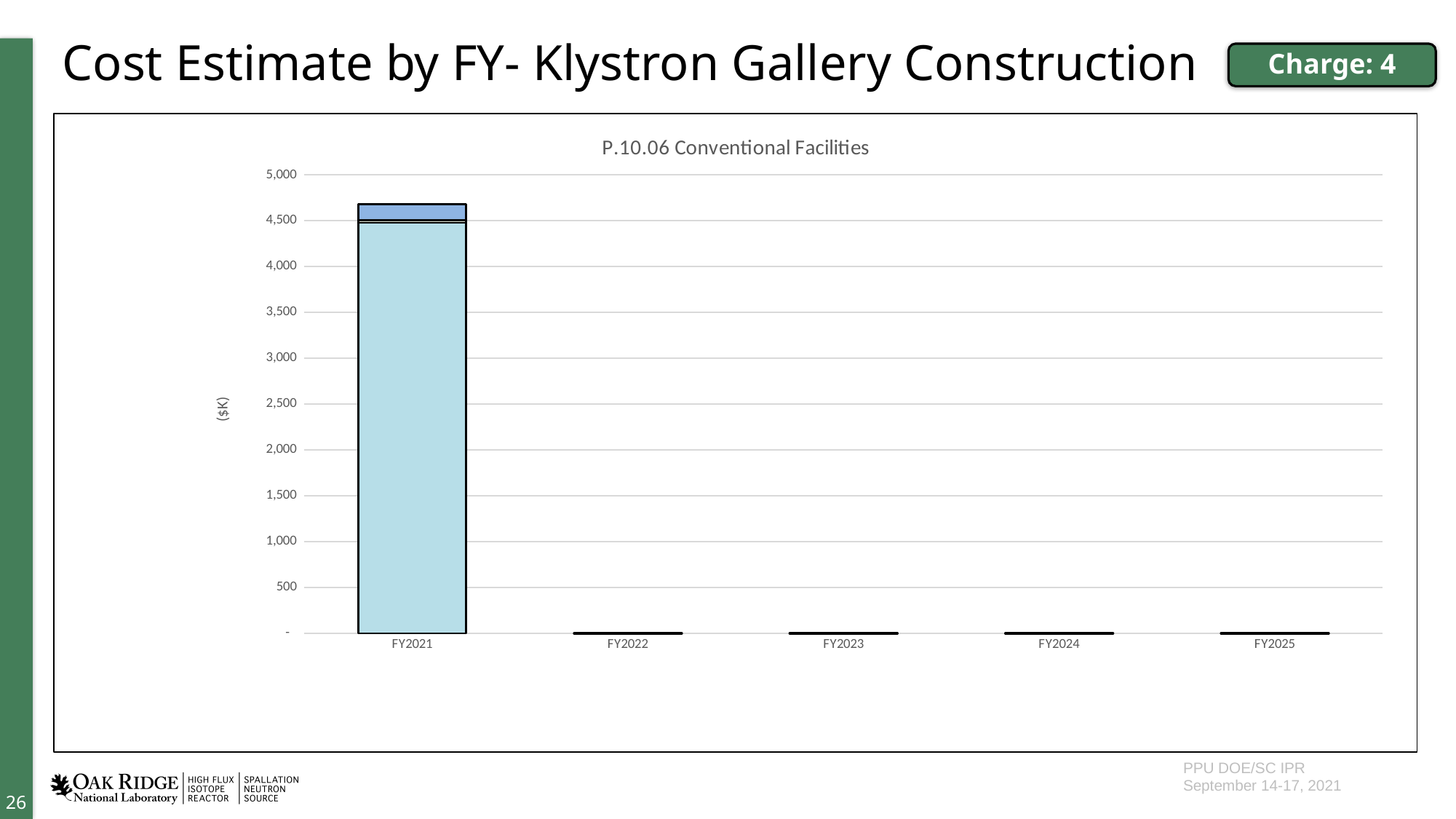
What is the label on the vertical axis of the chart? ($K) Which has the larger value, FY2021 or FY2022? FY2021 What kind of chart is shown on the slide? bar chart What is the title of the chart? P.10.06 Conventional Facilities Is the total value for FY2021 greater or less than 5,000? less Is the total value for FY2021 greater or less than 4,000? greater What is the first fiscal year shown on the x axis? FY2021 What is the highest tick value shown on the vertical axis? 5,000 How many fiscal years are shown on the x axis of the chart? 5 Which fiscal year has the highest value in the chart? FY2021 Is the value for FY2023 greater or less than 500? less Do the values rise or fall from FY2021 to FY2025? fall